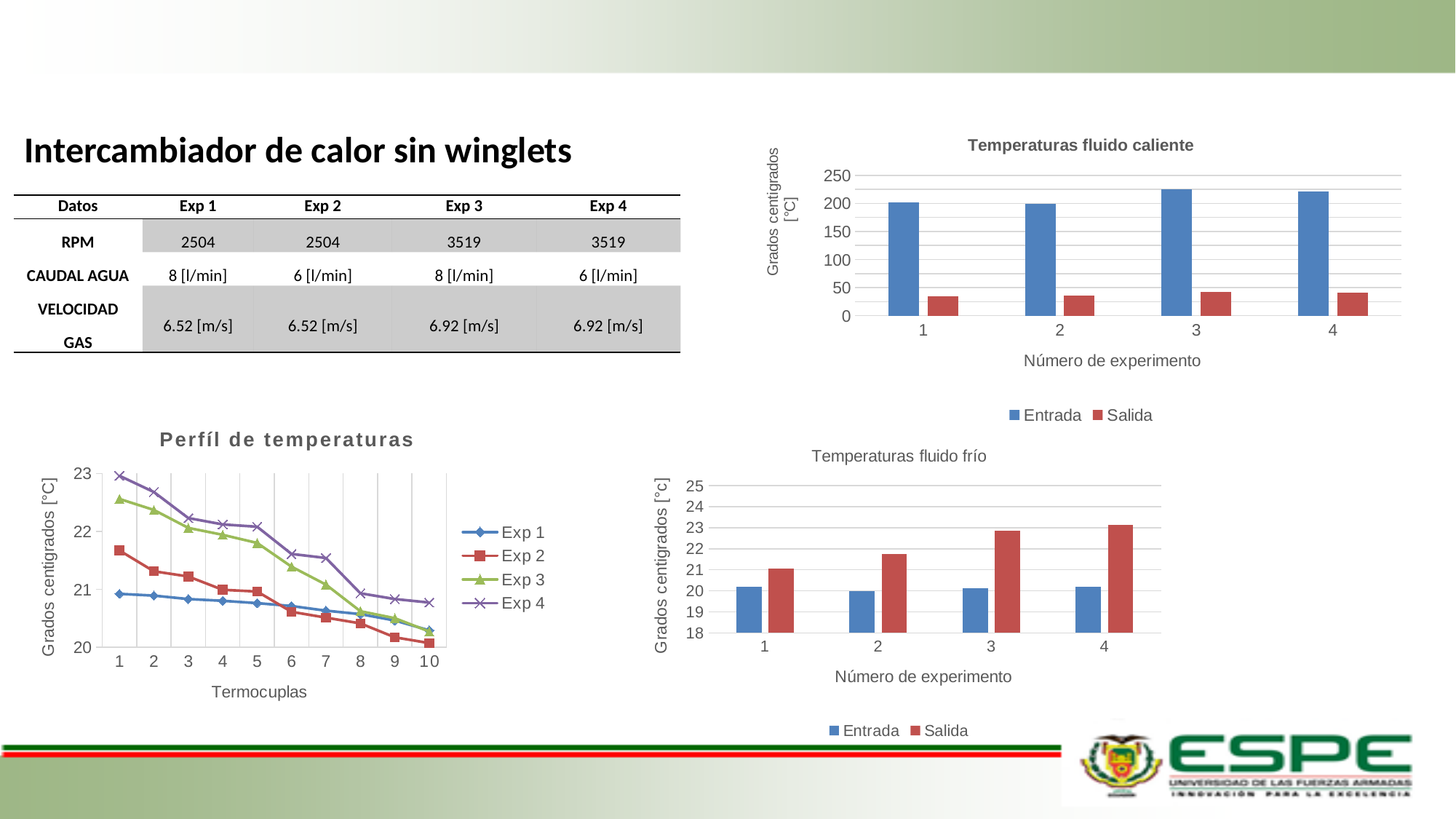
In the "Perfíl de temperaturas" chart, which series has the highest value at thermocouple 1? Exp 4 In the "Temperaturas fluido frío" chart, which experiment has the lowest Salida value? 1 In the "Perfíl de temperaturas" chart, is the value for Exp 4 at thermocouple 1 greater or less than 22? greater In the "Perfíl de temperaturas" chart, how many thermocouple points are plotted along the x axis? 10 In the "Temperaturas fluido caliente" chart, which is larger for experiment 3, Entrada or Salida? Entrada In the "Temperaturas fluido caliente" chart, is the Salida value for experiment 2 greater or less than 50? less What kind of chart is "Temperaturas fluido caliente"? bar chart In the "Perfíl de temperaturas" chart, how many series does the legend list? 4 In the "Perfíl de temperaturas" chart, do the values for Exp 4 rise or fall from thermocouple 1 to thermocouple 10? fall In the "Temperaturas fluido frío" chart, is the Salida value for experiment 3 greater or less than 22? greater What kind of chart is "Perfíl de temperaturas"? line chart